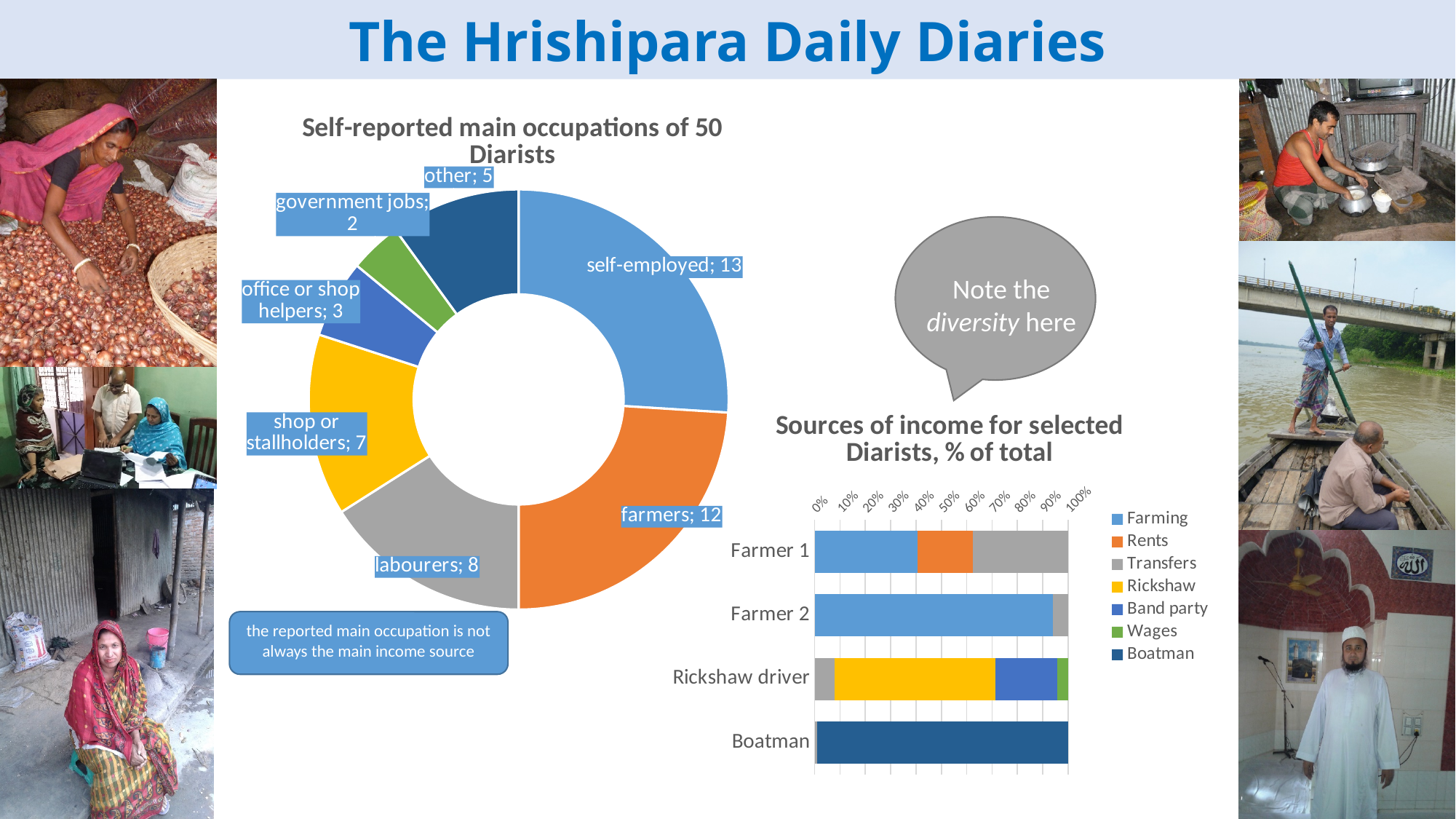
In the 'Self-reported main occupations of 50 Diarists' chart, which occupation has the smallest number of diarists? government jobs In the 'Self-reported main occupations of 50 Diarists' chart, which occupation has the largest number of diarists? self-employed In the 'Sources of income for selected Diarists, % of total' chart, is the Farming share for Farmer 1 greater or less than 50%? less How many series does the legend of the 'Sources of income for selected Diarists, % of total' chart list? 7 What type of chart is 'Sources of income for selected Diarists, % of total'? stacked bar chart How many occupation categories are shown in the 'Self-reported main occupations of 50 Diarists' chart? 7 In the 'Self-reported main occupations of 50 Diarists' chart, how many diarists are labourers? 8 In the 'Self-reported main occupations of 50 Diarists' chart, how many diarists reported being self-employed? 13 In the 'Self-reported main occupations of 50 Diarists' chart, what is the difference between the number of farmers and the number of shop or stallholders? 5 In the 'Self-reported main occupations of 50 Diarists' chart, which has more diarists: labourers or office or shop helpers? labourers In the 'Sources of income for selected Diarists, % of total' chart, is the Farming share for Farmer 2 greater or less than 80%? greater In the 'Self-reported main occupations of 50 Diarists' chart, what share of the 50 diarists are farmers? 24%